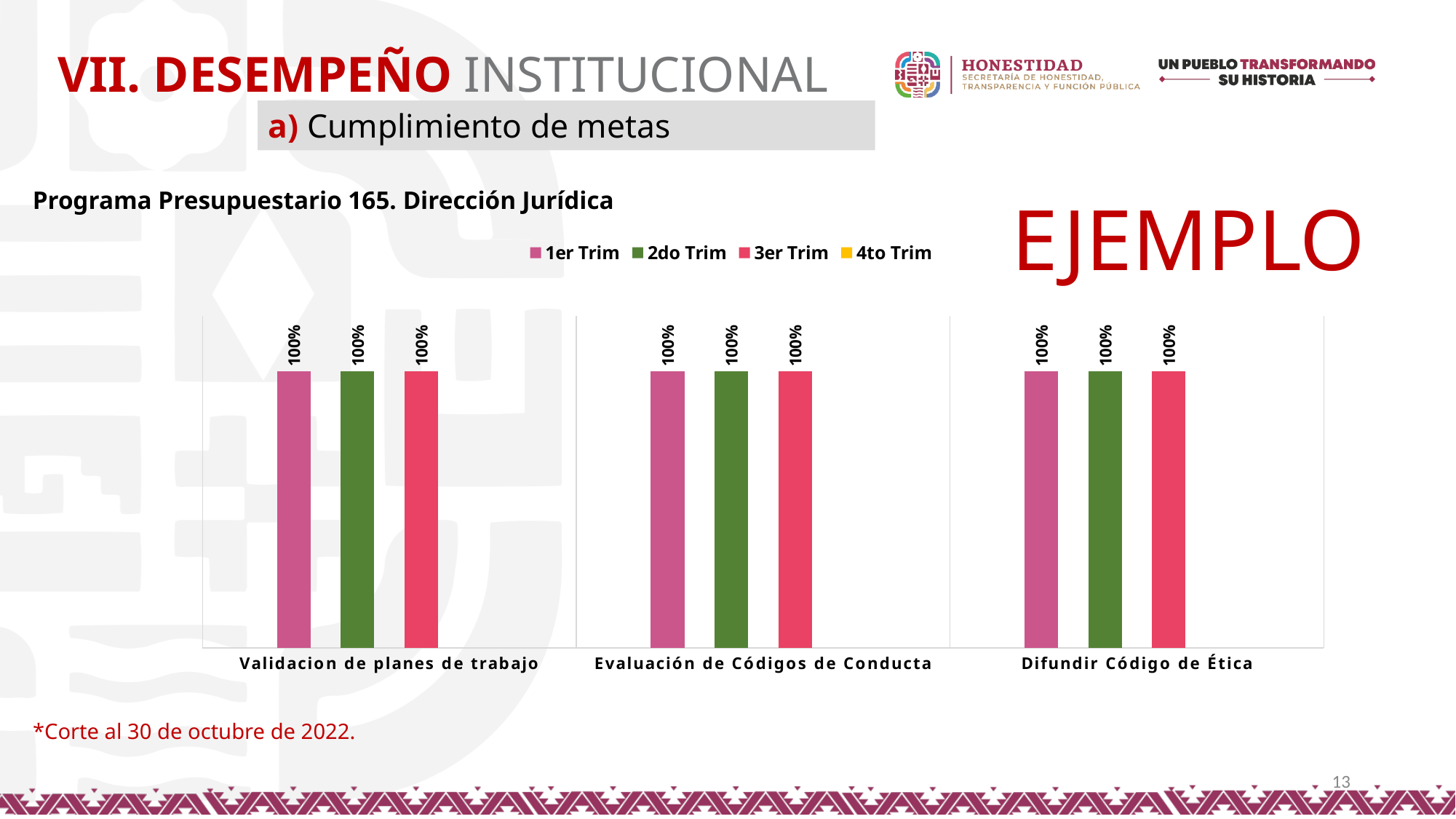
What is the value for 2do Trim in the category Difundir Código de Ética? 100% What kind of chart is shown on the slide? bar chart What is the value for 3er Trim in the category Validacion de planes de trabajo? 100% How many categories are shown on the x axis of the chart? 3 Which legend series has no bars plotted in the chart? 4to Trim What colour are the bars for 2do Trim? green What is the difference between the 1er Trim value and the 3er Trim value for Difundir Código de Ética? 0% What is the value for 1er Trim in the category Validacion de planes de trabajo? 100% What is the value for 2do Trim in the category Evaluación de Códigos de Conducta? 100% How many series does the chart's legend list? 4 What is the value for 3er Trim in the category Difundir Código de Ética? 100% Do the values for 1er Trim rise, fall, or stay the same across the three categories? stay the same